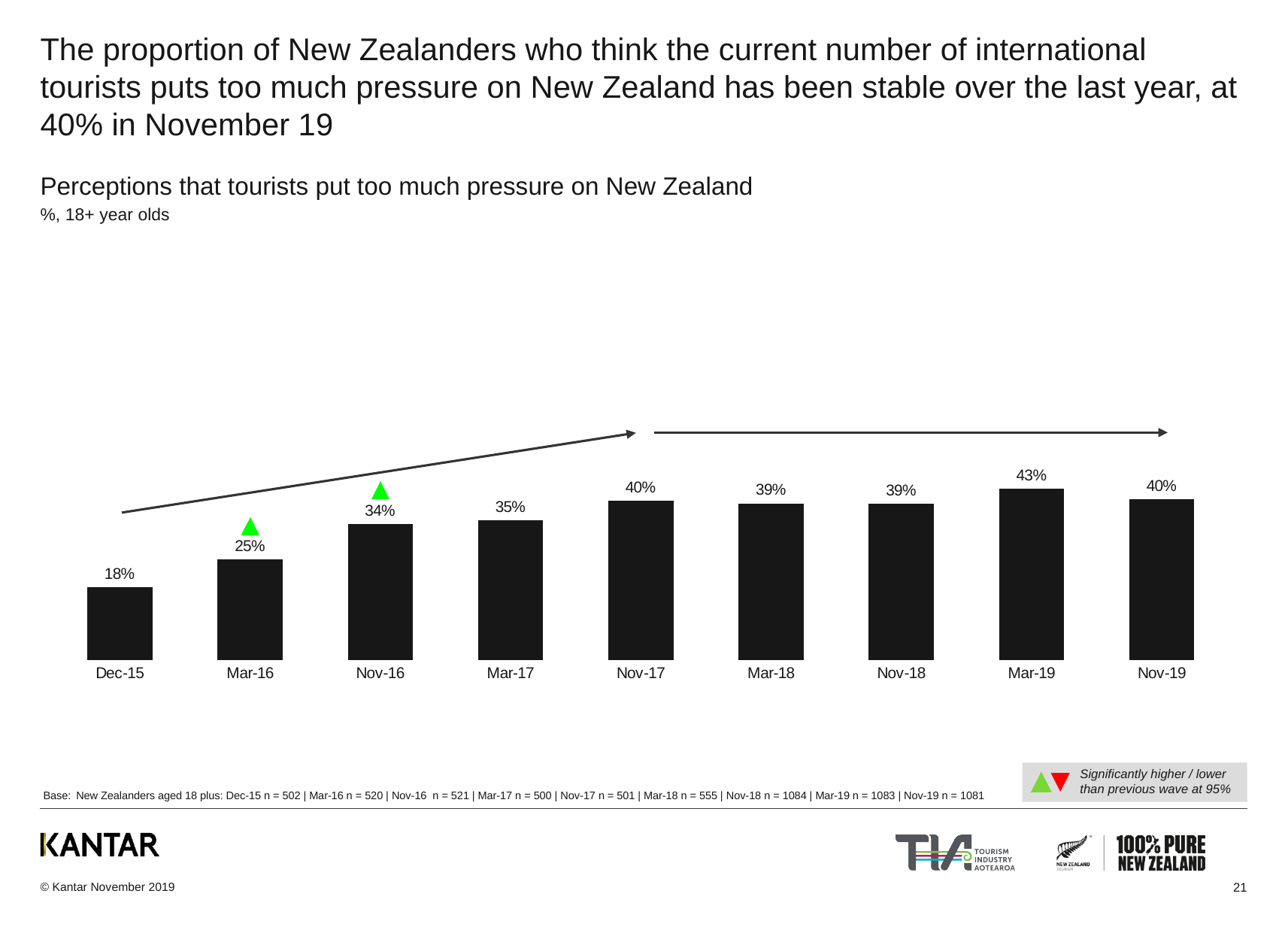
What is the difference between the values for Mar-19 and Nov-19? 3 percentage points What is the value for Nov-16? 34% What is the value for Mar-19? 43% What is the value for Dec-15? 18% Which period has the lowest value? Dec-15 Do the values rise or fall from Dec-15 to Nov-17? Rise What kind of chart is shown on the slide? Bar chart Which period has the highest value? Mar-19 Which is larger, the value for Mar-16 or the value for Mar-17? Mar-17 What is the difference between the values for Nov-19 and Dec-15? 22 percentage points How many periods are shown on the x axis? 9 What is the value for Nov-19? 40%